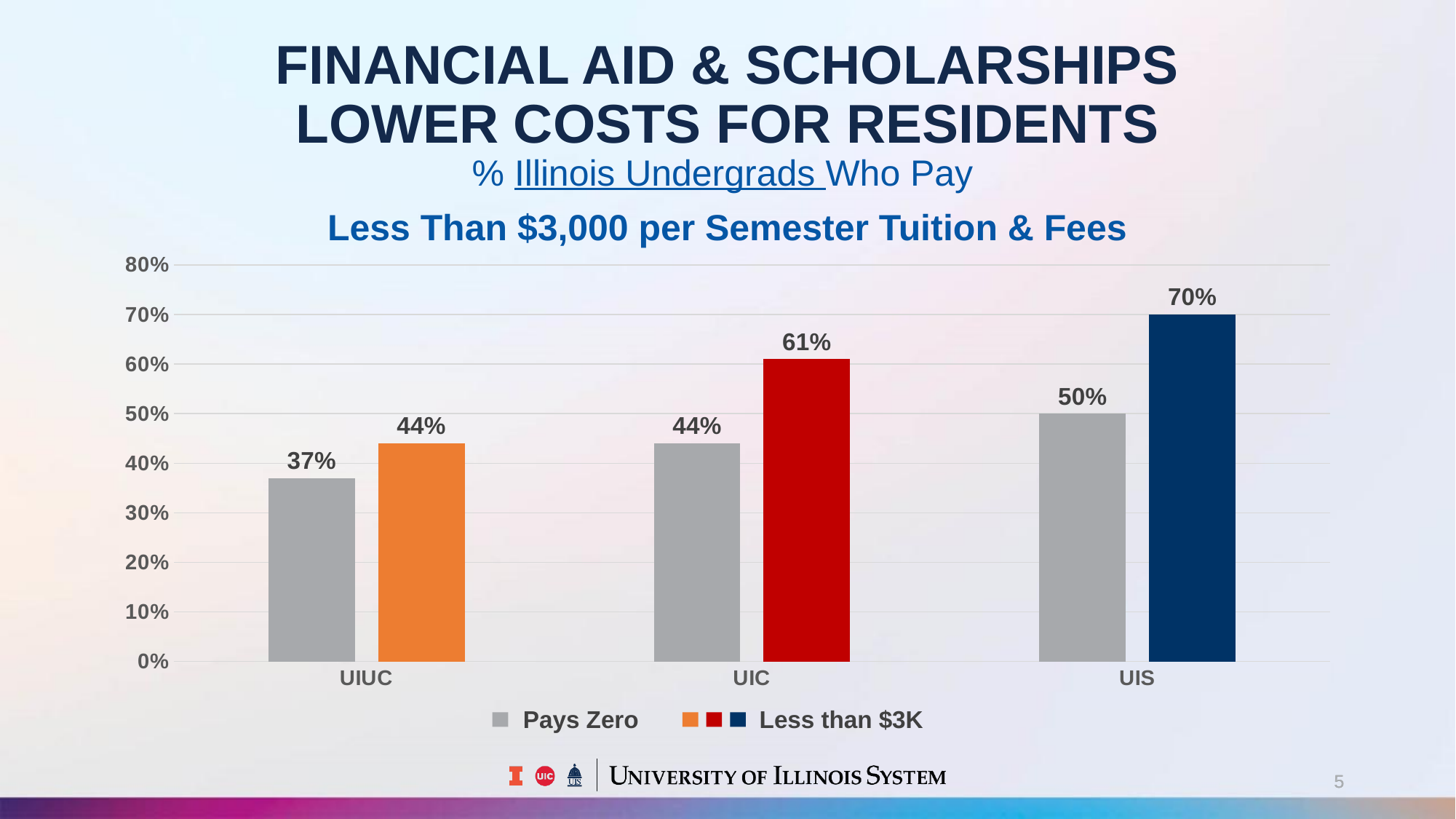
What is the chart's title? % Illinois Undergrads Who Pay Less Than $3,000 per Semester Tuition & Fees What kind of chart is shown on the slide? Bar chart What percentage of Illinois undergrads at UIUC pay zero tuition and fees? 37% What is the difference between the 'Less than $3K' value for UIS and the 'Less than $3K' value for UIUC? 26% How many campuses are shown on the x axis? 3 Which campus has the highest 'Less than $3K' value? UIS What is the difference between the 'Pays Zero' and 'Less than $3K' values for UIC? 17% Which is larger: the 'Pays Zero' value for UIS or the 'Less than $3K' value for UIUC? Pays Zero for UIS Which campus has the lowest 'Pays Zero' value? UIUC What is the 'Less than $3K' value for UIC? 61% How many series does the legend list? 2 What is the 'Pays Zero' value for UIS? 50%